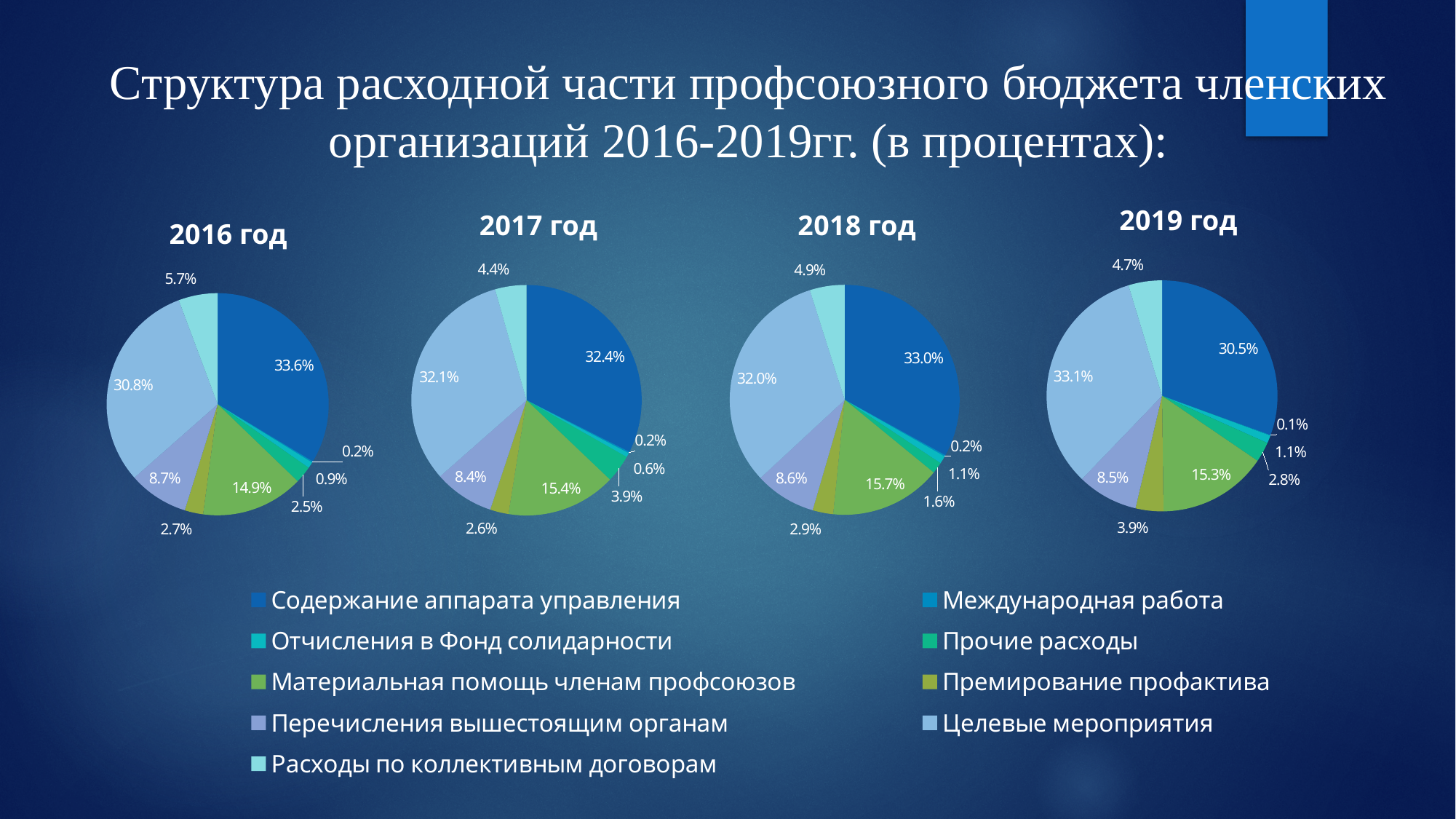
In the 2018 год chart, what is the share for Материальная помощь членам профсоюзов? 15.7% In the 2019 год chart, which is larger: the share for Перечисления вышестоящим органам or the share for Расходы по коллективным договорам? Перечисления вышестоящим органам What type of charts are shown on the slide? Pie charts In the 2017 год chart, what is the share for Целевые мероприятия? 32.1% How many pie charts are on the slide? 4 In the 2019 год chart, what is the share for Премирование профактива? 3.9% In the 2019 год chart, which category has the largest share? Целевые мероприятия In the 2017 год chart, what is the share for Расходы по коллективным договорам? 4.4% In the 2018 год chart, what is the difference between the shares for Содержание аппарата управления and Целевые мероприятия? 1.0% How many categories does the legend list? 9 In the 2016 год chart, what is the share for Содержание аппарата управления? 33.6% In the 2016 год chart, which category has the smallest share? Международная работа